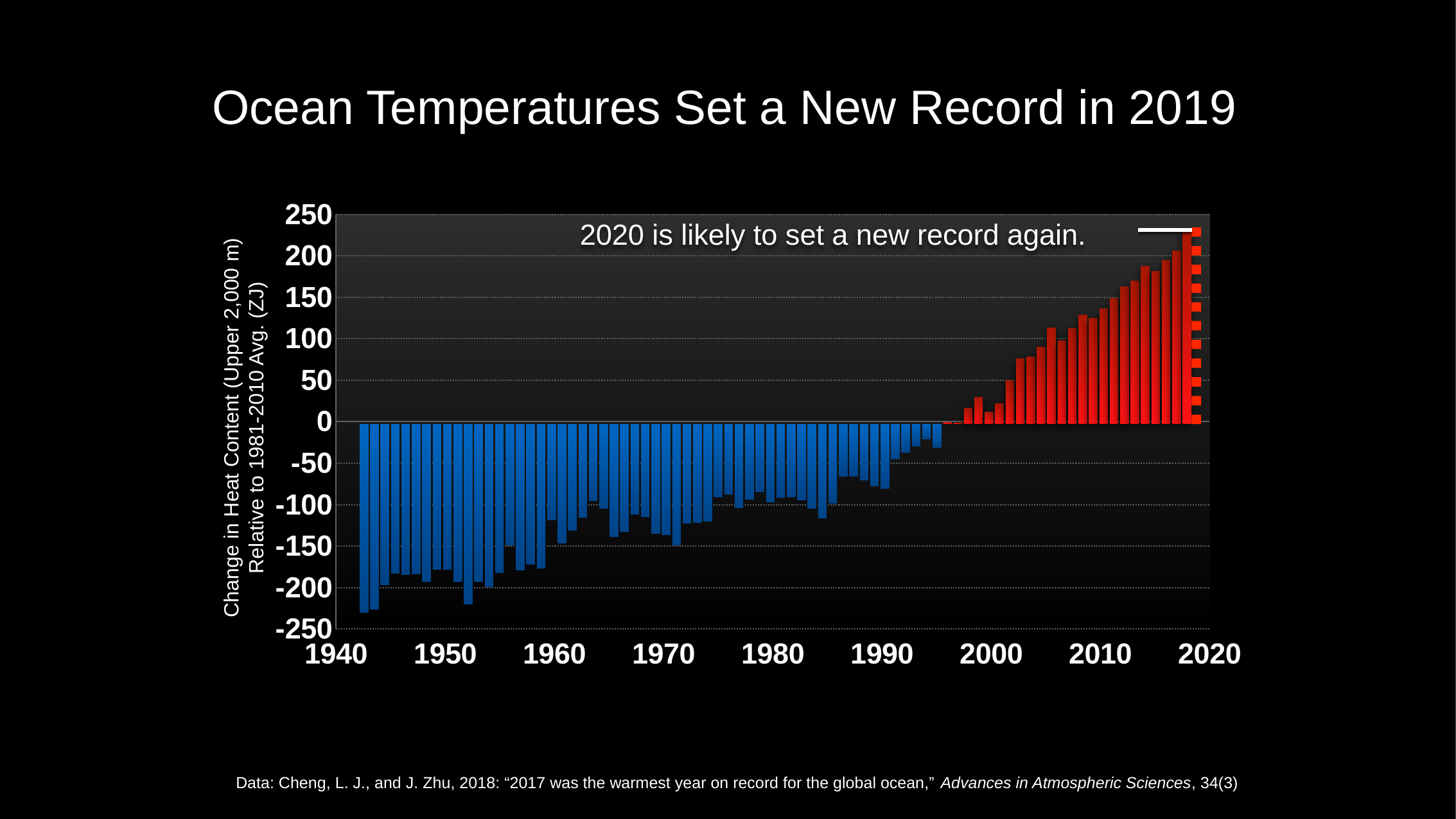
Overall, do the values rise or fall from 1940 to 2020? Rise What is the title of the slide? Ocean Temperatures Set a New Record in 2019 What kind of chart is shown on the slide? Bar chart Is the value for 2010 greater or less than 100? greater Is the value for 1950 greater or less than -150? less Which year has the highest change in heat content? 2019 Which year has the larger value, 1950 or 1980? 1980 Which year has the larger value, 2010 or 2019? 2019 Is the value for 2019 greater or less than 200? greater What colour are the bars with values below zero? Blue